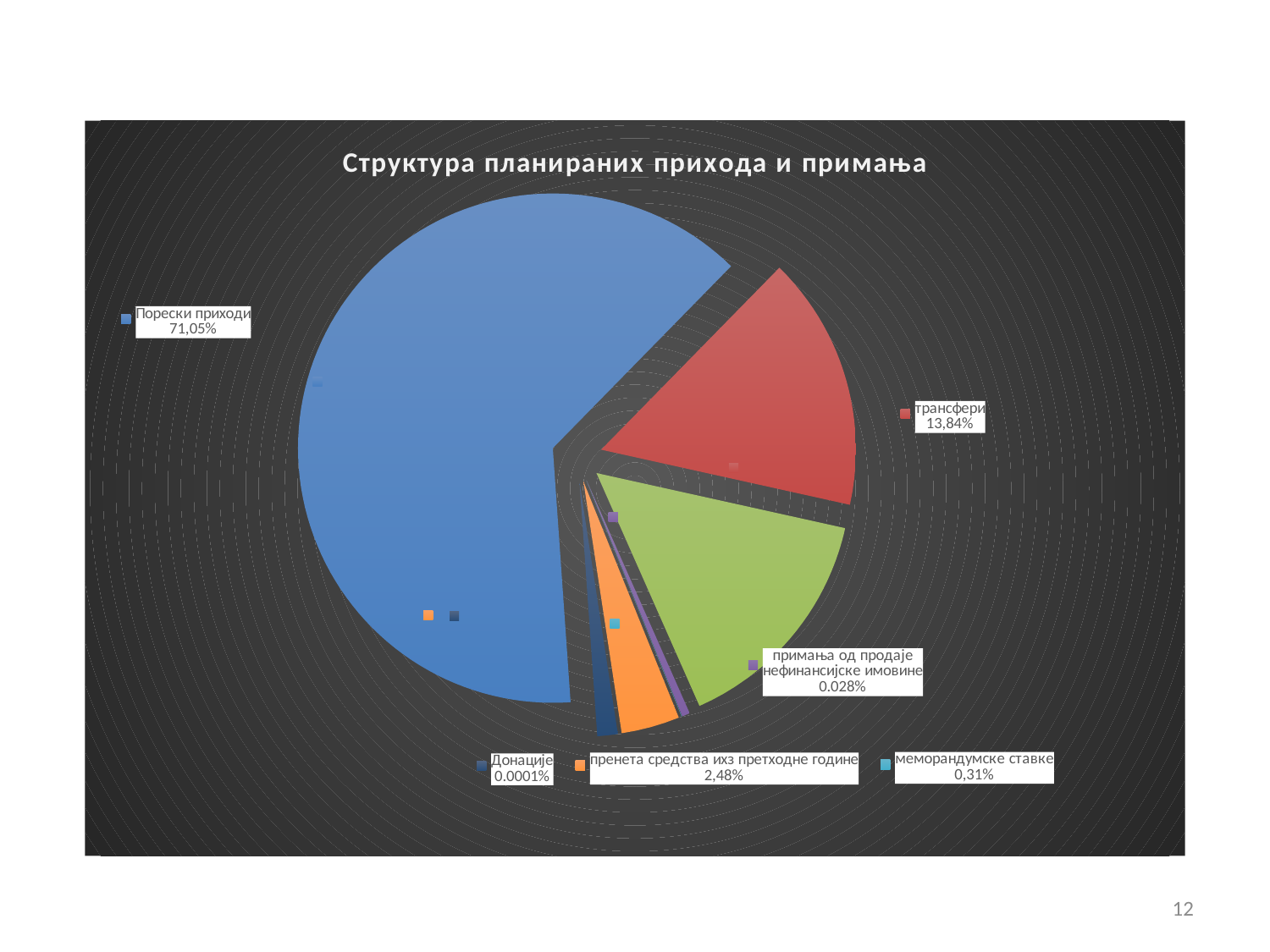
Which labeled category has the largest share of the pie? Порески приходи What is the title of the chart? Структура планираних прихода и примања What share does Порески приходи have in the pie chart? 71,05% What is the value shown for пренета средства из претходне године? 2,48% What is the value shown for меморандумске ставке? 0,31% What is the value shown for трансфери? 13,84% What is the difference between the shares of Порески приходи and трансфери? 57,21% What is the value shown for примања од продаје нефинансијске имовине? 0.028% What kind of chart is shown on the slide? pie chart Which is larger, трансфери or пренета средства из претходне године? трансфери What is the value shown for Донације? 0.0001%